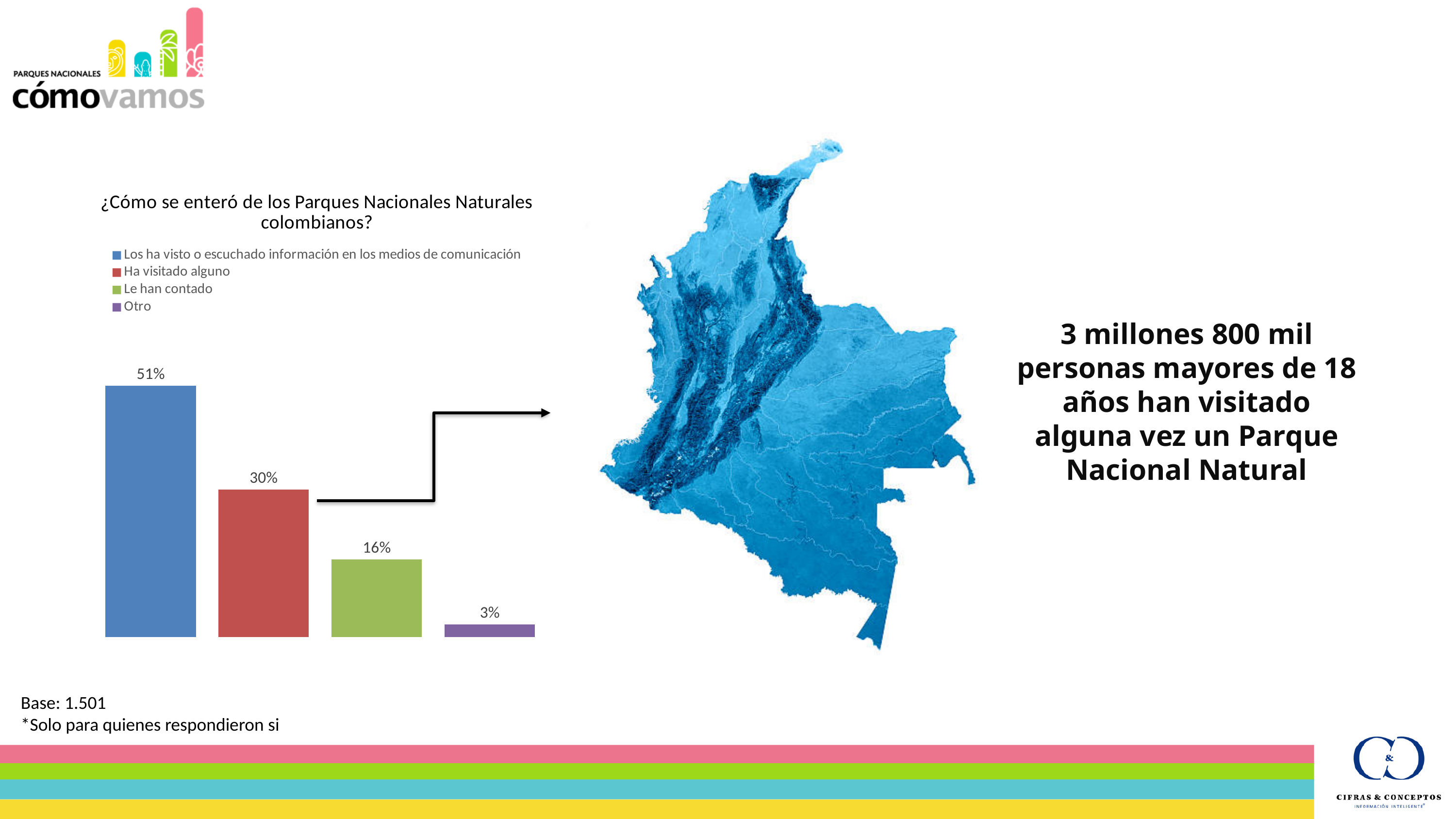
What percentage of respondents answered Otro? 3% Which response category has the highest percentage? Los ha visto o escuchado información en los medios de comunicación What percentage of respondents said they were told about the parks (Le han contado)? 16% How many response categories are shown in the chart? 4 What is the title of the chart? ¿Cómo se enteró de los Parques Nacionales Naturales colombianos? What percentage of respondents said they learned about the Parques Nacionales Naturales because they have seen or heard information in the media (Los ha visto o escuchado información en los medios de comunicación)? 51% How many entries does the chart legend list? 4 Which response category has the lowest percentage? Otro What percentage of respondents said they have visited one (Ha visitado alguno)? 30% What is the difference in percentage points between 'Los ha visto o escuchado información en los medios de comunicación' and 'Ha visitado alguno'? 21 percentage points What type of chart is used to show how people learned about the Parques Nacionales Naturales? Bar chart Which is larger: the percentage for 'Le han contado' or for 'Otro'? Le han contado